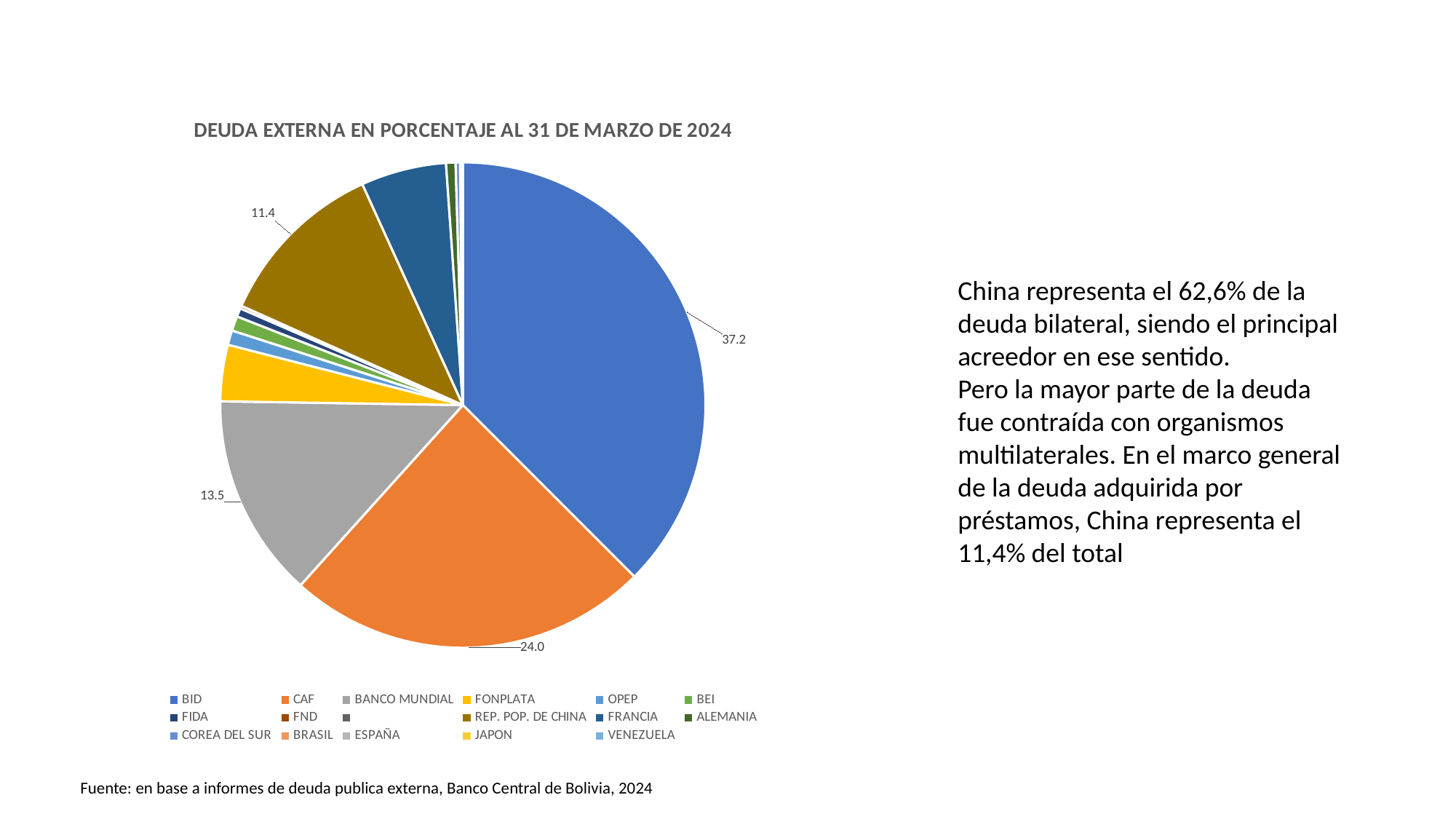
What kind of chart is shown on the slide? pie chart What colour is the BID slice in the pie chart? blue Which is larger, the slice for BANCO MUNDIAL or the slice for REP. POP. DE CHINA? BANCO MUNDIAL What is the difference between the values for CAF and BANCO MUNDIAL? 10.5 What is the value shown for BID in the pie chart? 37.2 What is the difference between the values for BID and CAF? 13.2 What is the difference between the values for BANCO MUNDIAL and REP. POP. DE CHINA? 2.1 What is the value shown for CAF in the pie chart? 24.0 What is the value shown for REP. POP. DE CHINA in the pie chart? 11.4 Which category has the largest slice of the pie chart? BID What is the value shown for BANCO MUNDIAL in the pie chart? 13.5 What is the title of the pie chart? DEUDA EXTERNA EN PORCENTAJE AL 31 DE MARZO DE 2024